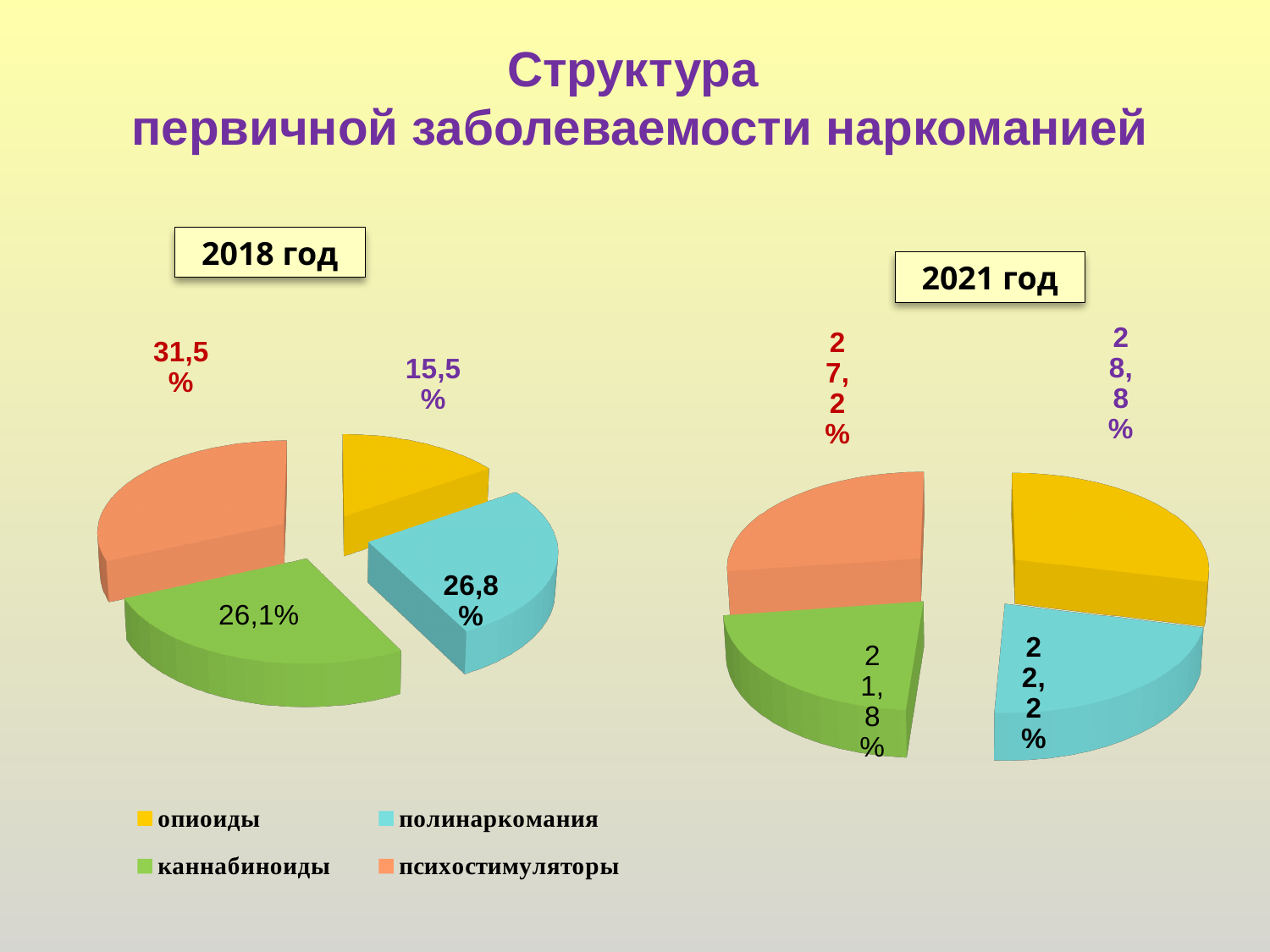
In the 2018 год pie chart, which category has the largest share? психостимуляторы In the 2021 год pie chart, which is larger: the share of полинаркомания or the share of психостимуляторы? психостимуляторы In the 2021 год pie chart, what is the share for каннабиноиды? 21,8% In the 2018 год pie chart, what is the share for психостимуляторы? 31,5% In the 2018 год pie chart, what is the difference between the shares of психостимуляторы and опиоиды? 16 percentage points In the 2021 год pie chart, which category has the smallest share? каннабиноиды In the 2021 год pie chart, which category has the largest share? опиоиды How many categories does the legend list? 4 In the 2021 год pie chart, what is the share for опиоиды? 28,8% In the 2018 год pie chart, which category has the smallest share? опиоиды What type of chart is used on this slide? Pie chart In the 2018 год pie chart, what is the share for опиоиды? 15,5%